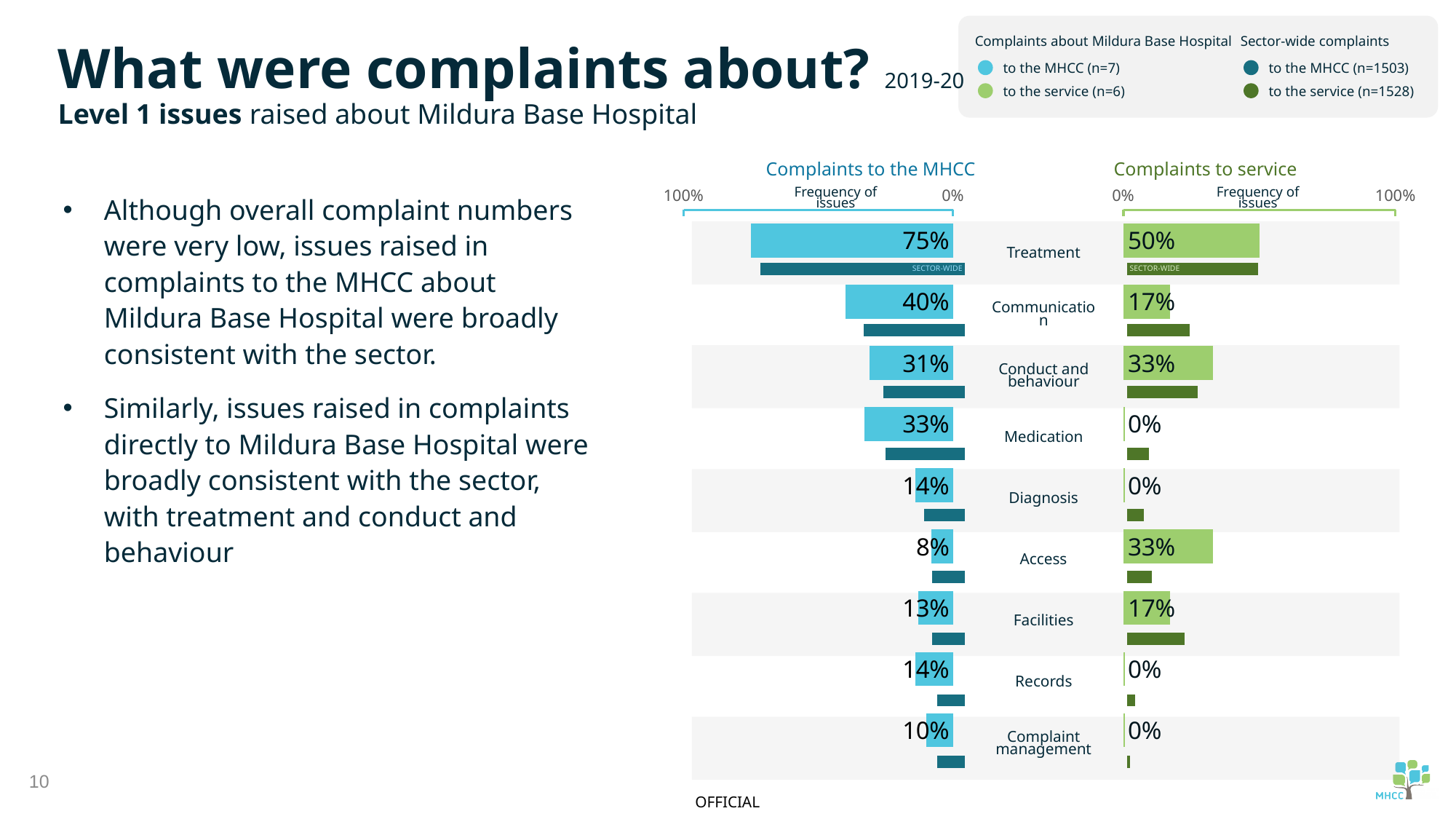
In the Complaints to the MHCC chart, what is the value for Communication? 40% For Access, which is larger: the Complaints to the MHCC value or the Complaints to service value? Complaints to service In the Complaints to the MHCC chart, which issue has the highest frequency? Treatment In the Complaints to the MHCC chart, which issue has the lowest frequency? Access What is the difference between the Treatment values in the Complaints to the MHCC chart and the Complaints to service chart? 25% How many issue categories are shown in the chart? 9 In the Complaints to service chart, which issue has the highest frequency? Treatment In the Complaints to the MHCC chart, what is the value for Treatment? 75% In the Complaints to service chart, what is the value for Medication? 0% What kind of chart is shown on the slide? Bar chart In the Complaints to service chart, what is the value for Conduct and behaviour? 33% How many series does the legend list? 4